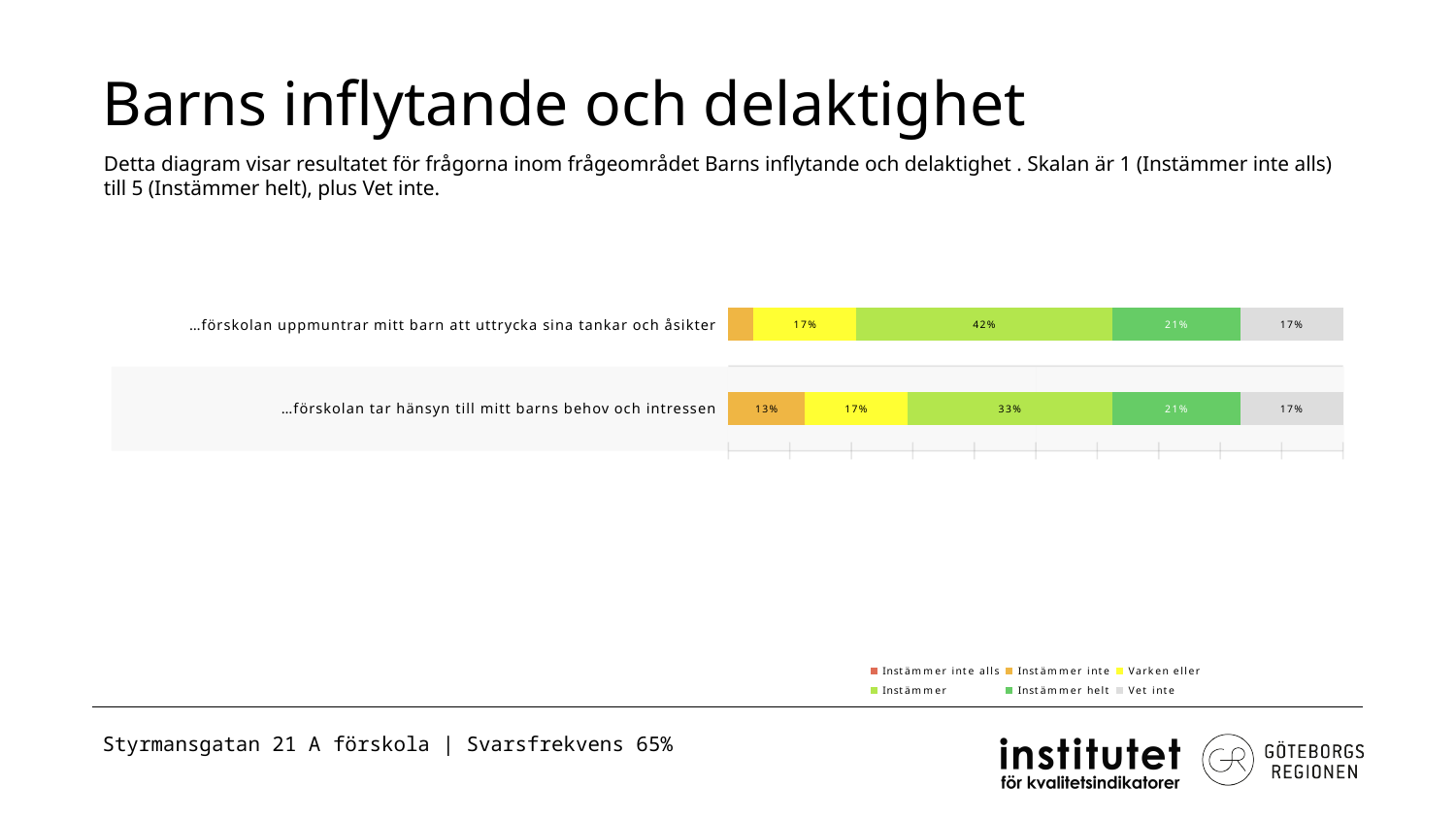
What is the 'Instämmer helt' value for '…förskolan tar hänsyn till mitt barns behov och intressen'? 21% What is the 'Vet inte' value for '…förskolan uppmuntrar mitt barn att uttrycka sina tankar och åsikter'? 17% How many statements (categories) are plotted in the chart? 2 Which response category has the largest share for '…förskolan tar hänsyn till mitt barns behov och intressen'? Instämmer What is the 'Instämmer' value for '…förskolan uppmuntrar mitt barn att uttrycka sina tankar och åsikter'? 42% Which statement has the larger 'Instämmer' share? …förskolan uppmuntrar mitt barn att uttrycka sina tankar och åsikter What is the title of the slide containing the chart? Barns inflytande och delaktighet What is the difference in the 'Instämmer' share between '…förskolan uppmuntrar mitt barn att uttrycka sina tankar och åsikter' and '…förskolan tar hänsyn till mitt barns behov och intressen'? 9 percentage points How many series does the legend list? 6 What is the 'Instämmer inte' value for '…förskolan tar hänsyn till mitt barns behov och intressen'? 13% What type of chart is shown on the slide? Stacked bar chart What is the 'Varken eller' value for '…förskolan tar hänsyn till mitt barns behov och intressen'? 17%